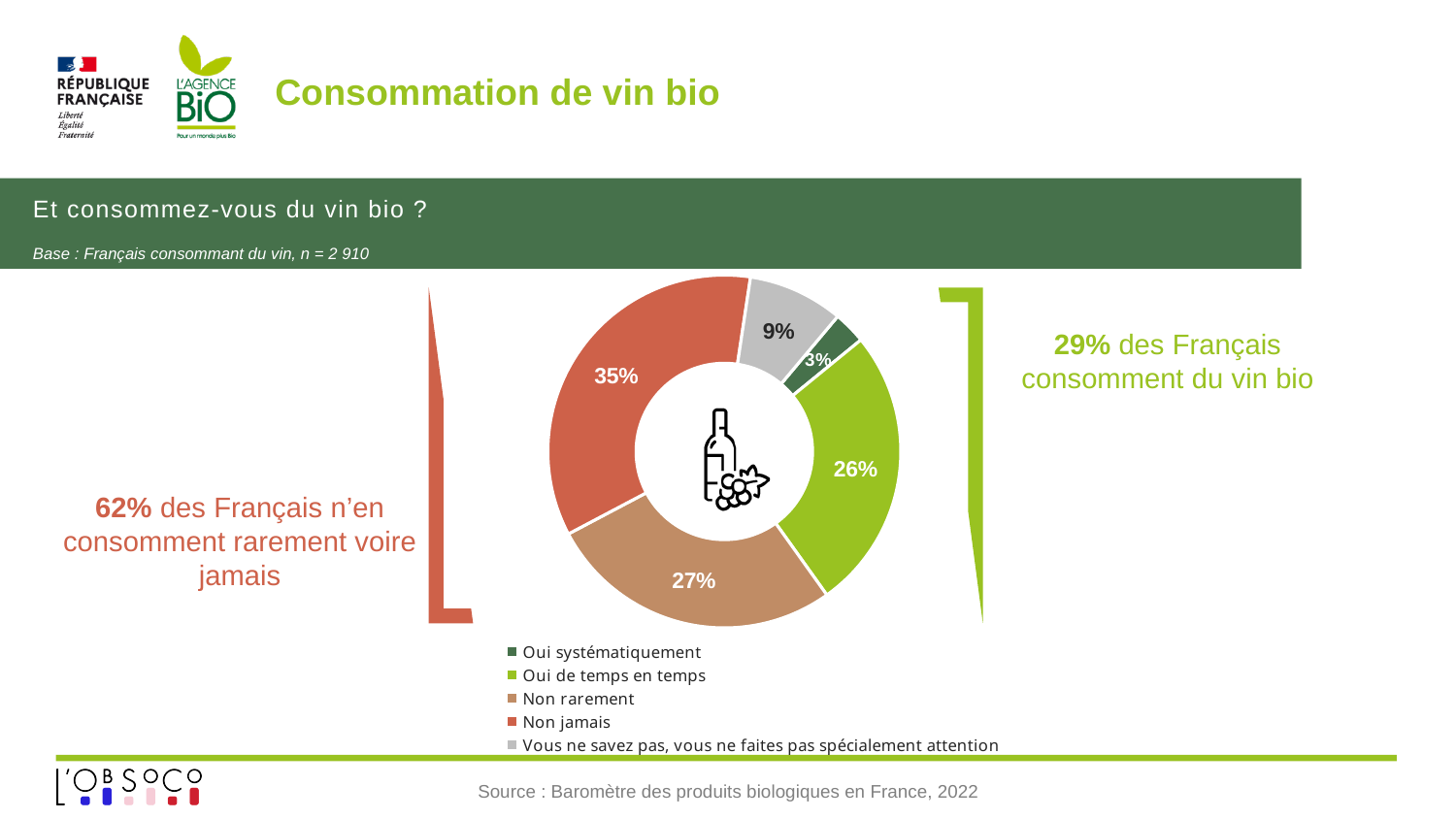
What percentage of respondents answered "Oui de temps en temps"? 26% What percentage of respondents answered "Oui systématiquement"? 3% Which response category has the smallest share of the chart? Oui systématiquement What type of chart is shown on the slide? Donut (pie) chart Which response category has the largest share of the chart? Non jamais How many response categories does the chart show? 5 What percentage of respondents answered "Non jamais"? 35% What is the difference in percentage points between "Non jamais" and "Non rarement"? 8 What percentage of respondents answered "Vous ne savez pas, vous ne faites pas spécialement attention"? 9% Which is larger, the share for "Non rarement" or the share for "Oui de temps en temps"? Non rarement What is the combined share of "Oui systématiquement" and "Oui de temps en temps"? 29% What is the sample size (n) stated for the chart's base? 2 910